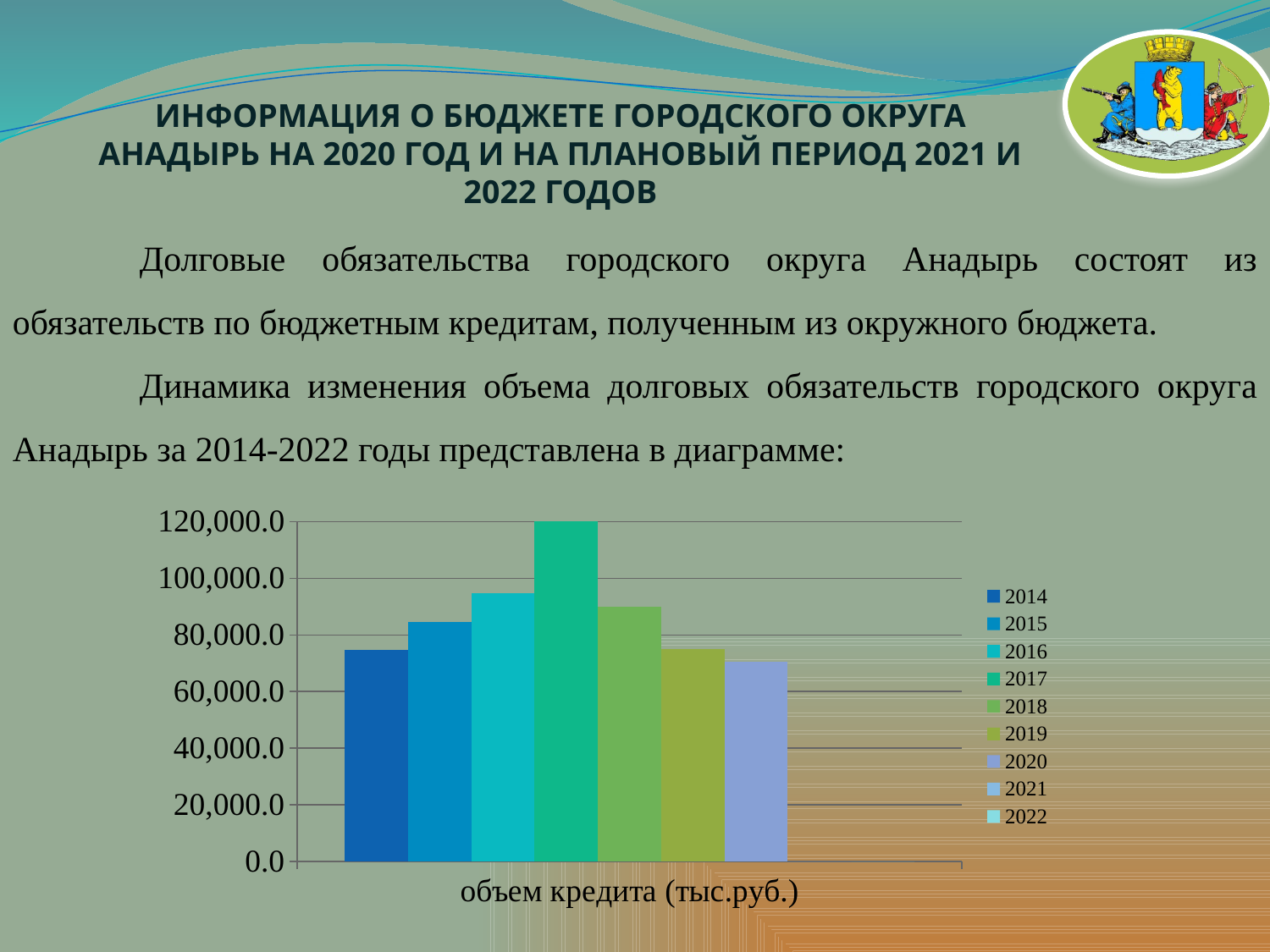
Is the value for 2015 greater or less than 80,000.0? greater Which is larger, the value for 2016 or the value for 2018? 2016 Do the values rise or fall from 2017 to 2020? fall What is the label shown under the horizontal axis of the chart? объем кредита (тыс.руб.) Which year has the highest value in the chart? 2017 Is the value for 2020 greater or less than 60,000.0? greater Is the value for 2014 greater or less than 80,000.0? less What is the value for 2017 in the chart? 120,000.0 Which is larger, the value for 2015 or the value for 2019? 2015 What type of chart is shown on the slide? bar chart How many series does the chart legend list? 9